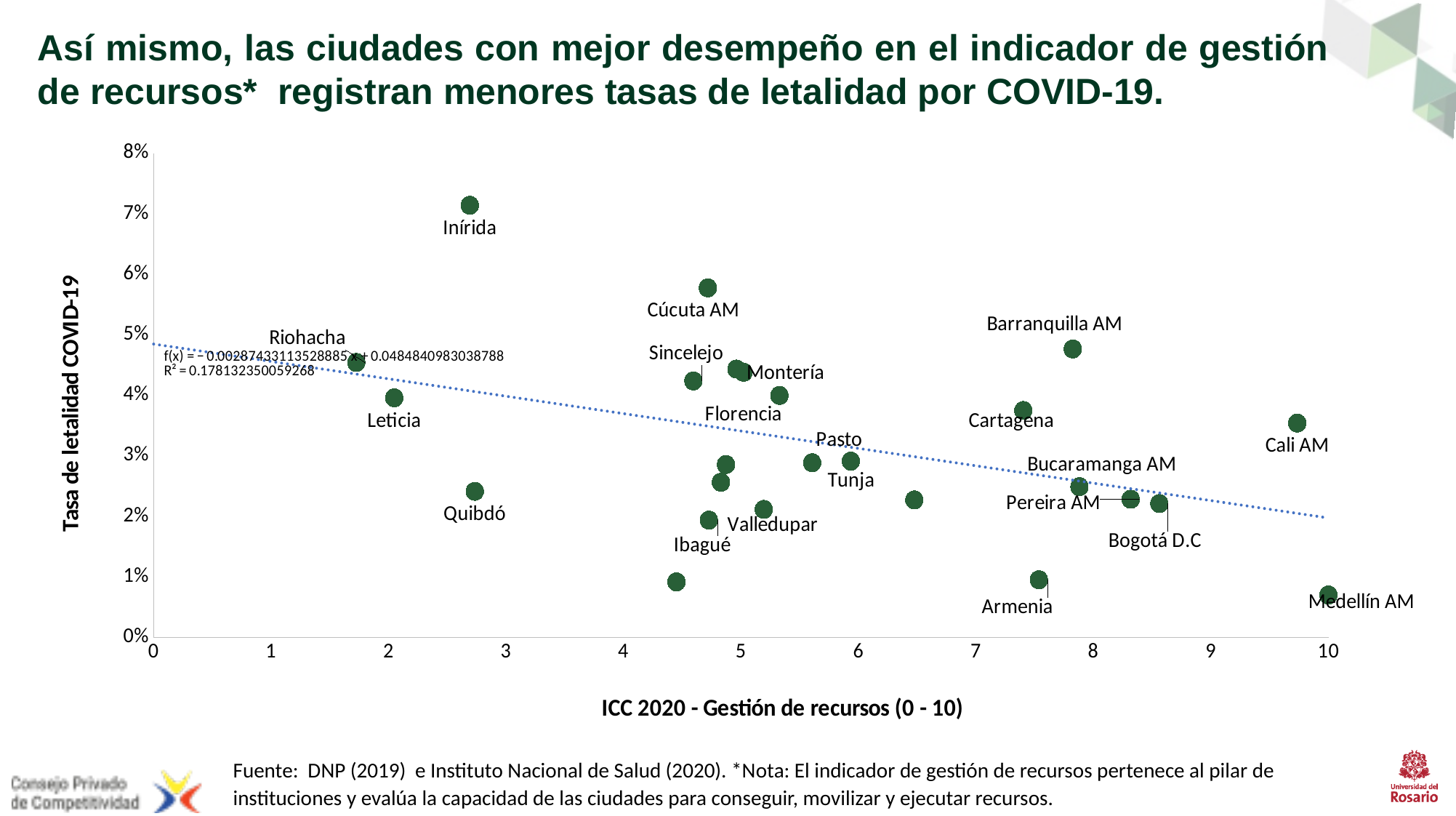
What kind of chart is shown on the slide? Scatter plot Is the fatality rate for Inírida greater or less than 6%? greater Is the fatality rate for Medellín AM greater or less than 1%? less Is the fatality rate for Barranquilla AM greater or less than 4%? greater Does the dotted trend line rise or fall as the ICC 2020 - Gestión de recursos score increases? Falls Which city has a higher fatality rate, Cali AM or Medellín AM? Cali AM Which city has the highest score on the ICC 2020 - Gestión de recursos axis? Medellín AM Which city has a higher fatality rate, Inírida or Cúcuta AM? Inírida What is the label of the x axis of the chart? ICC 2020 - Gestión de recursos (0 - 10) Which city has the highest COVID-19 fatality rate (Tasa de letalidad COVID-19) in the chart? Inírida